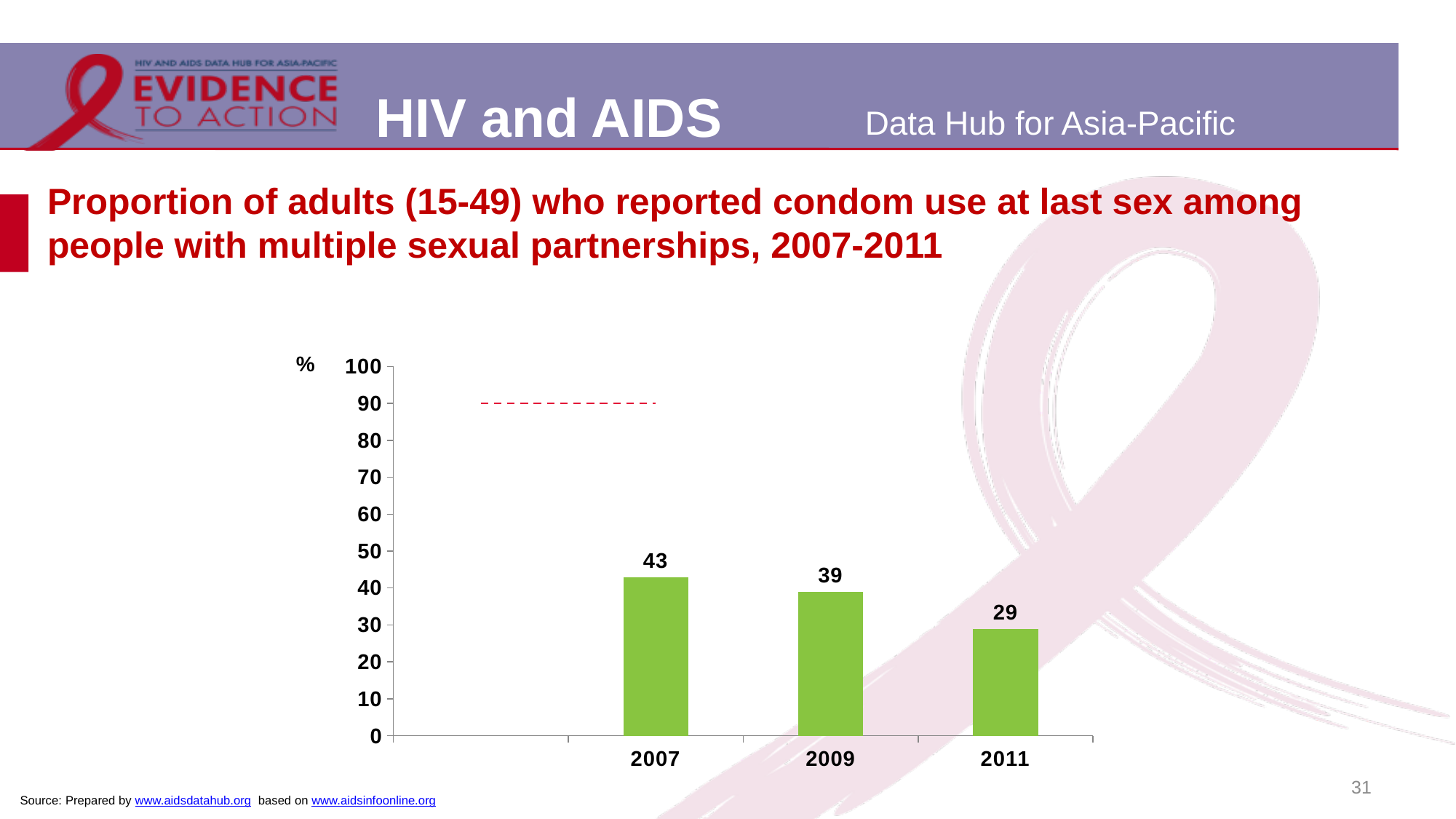
Is the value for 2011 greater or less than 30? less What is the value for 2011? 29 Which year has the lowest value? 2011 Do the values rise or fall from 2007 to 2011? fall What is the difference between the values for 2009 and 2011? 10 What is the value for 2009? 39 What is the value for 2007? 43 What is the difference between the values for 2007 and 2011? 14 What kind of chart is shown on the slide? bar chart Which is larger, the value for 2007 or the value for 2009? 2007 How many years are shown on the x axis? 3 Which year has the highest value? 2007